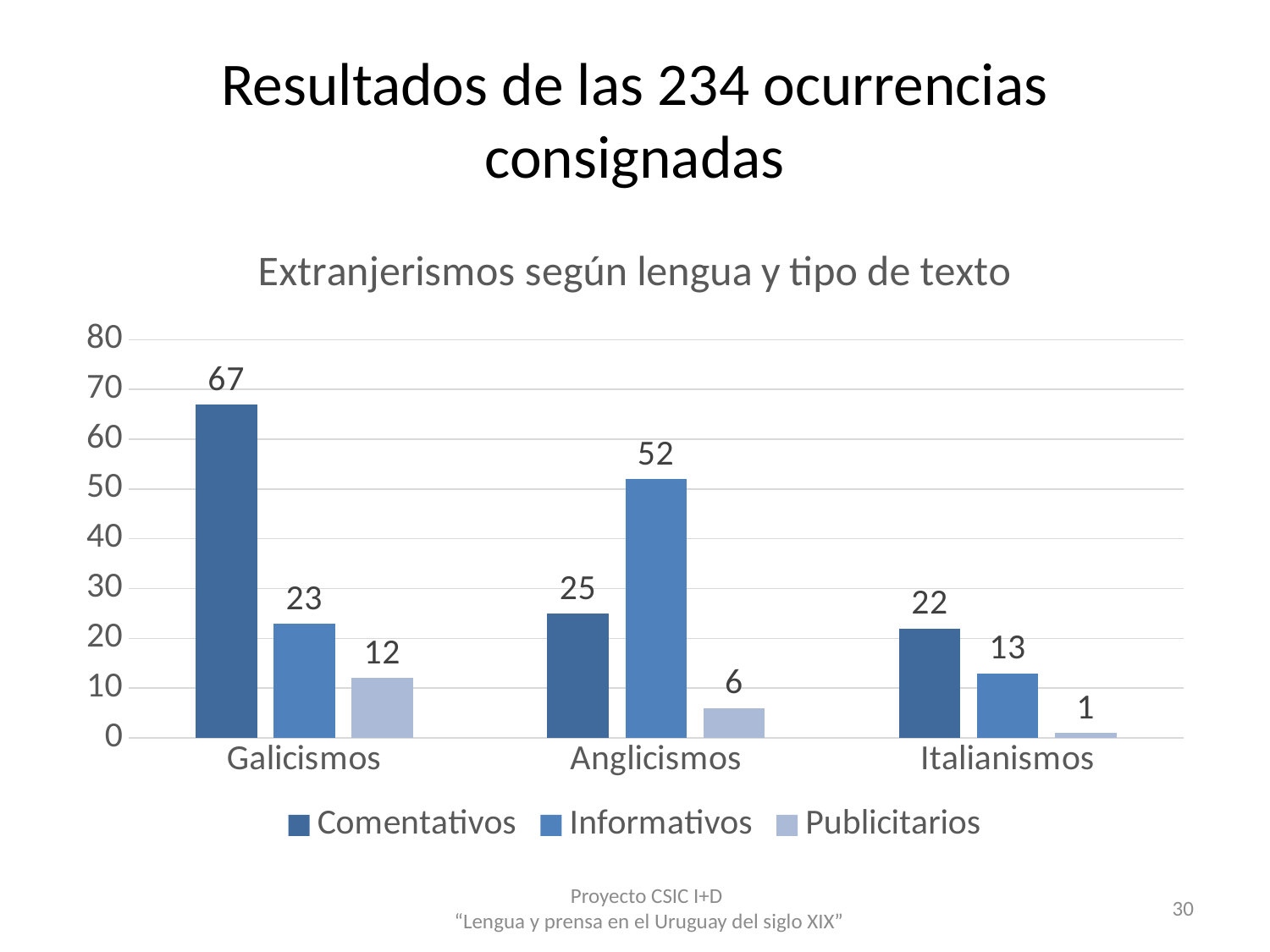
What kind of chart is shown on the slide? Bar chart What is the value for Comentativos in the Galicismos category? 67 What is the value for Informativos in the Anglicismos category? 52 What is the difference between the Comentativos and Informativos values for Galicismos? 44 Which is larger for Anglicismos: Comentativos or Informativos? Informativos Which category has the highest Comentativos value? Galicismos Which category has the lowest Publicitarios value? Italianismos How many series does the legend list? 3 How many categories are shown on the x axis? 3 What is the total of the three values for Italianismos? 36 What is the value for Publicitarios in the Italianismos category? 1 What is the title of the chart? Extranjerismos según lengua y tipo de texto